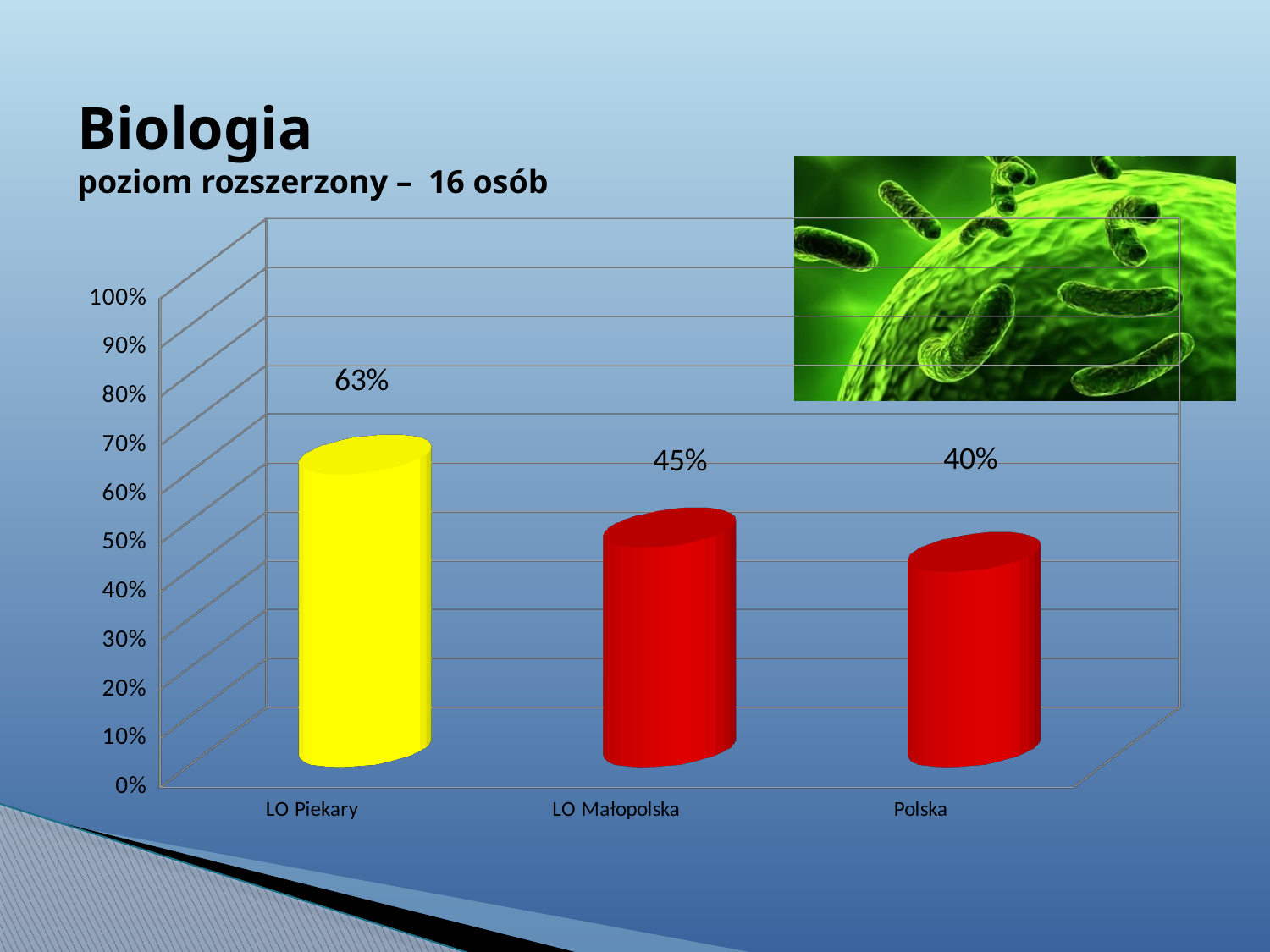
What colour is the bar for LO Piekary? yellow What is the value for Polska? 40% Is the value for LO Piekary greater or less than 50%? greater How many categories are shown on the chart? 3 What kind of chart is shown on the slide? bar chart What is the value for LO Piekary? 63% Which category has the highest value? LO Piekary What is the difference between the values for LO Małopolska and Polska? 5% Which category has the lowest value? Polska What is the difference between the values for LO Piekary and Polska? 23% Which is larger, the value for LO Piekary or the value for LO Małopolska? LO Piekary What is the value for LO Małopolska? 45%